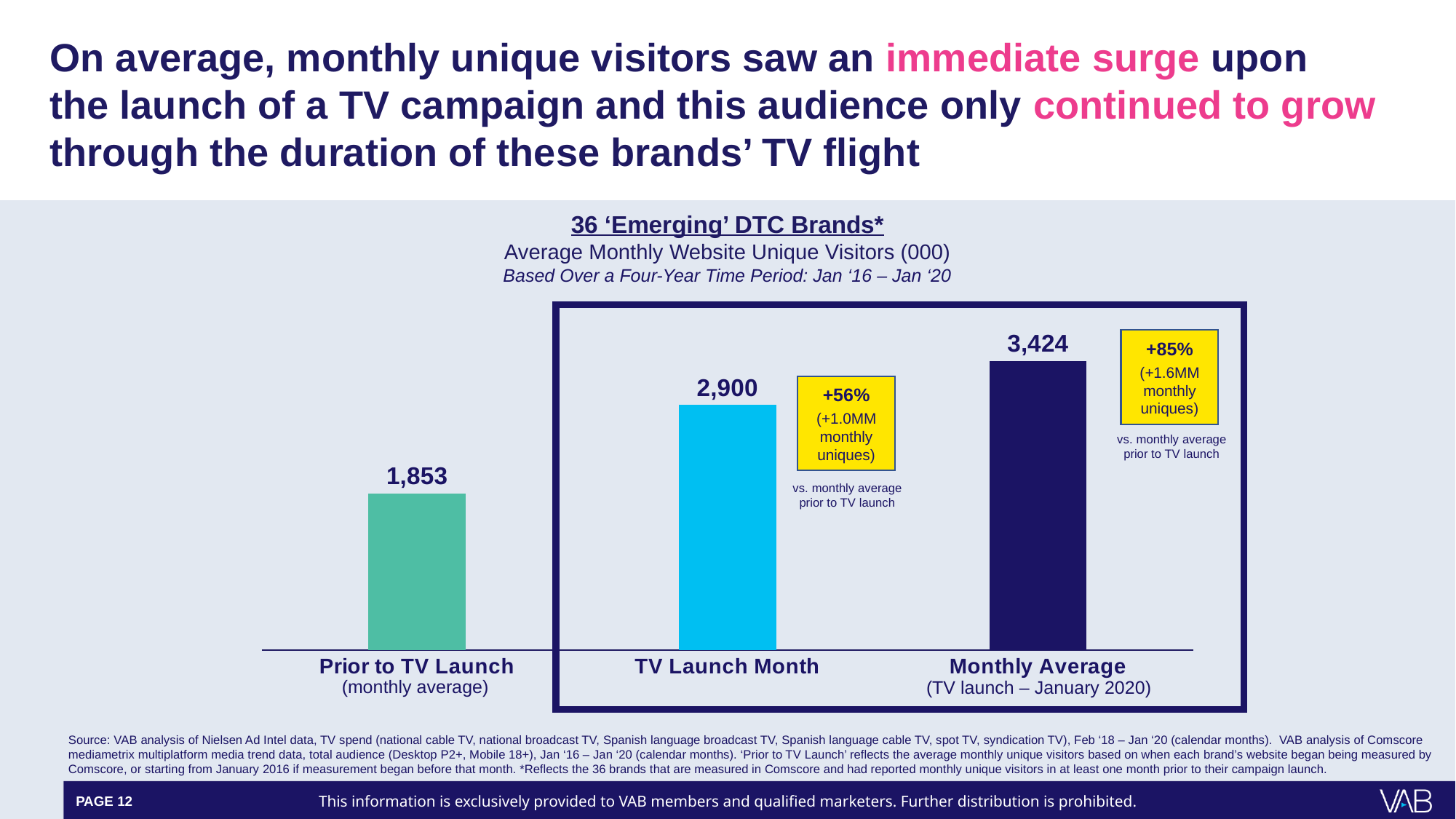
How many categories are shown in the chart? 3 Which category has the highest value? Monthly Average What is the difference between the Monthly Average and the Prior to TV Launch values? 1,571 What percentage increase is shown in the callout next to the Monthly Average bar? +85% What is the value for Prior to TV Launch? 1,853 What kind of chart is shown on the slide? Bar chart Do the values rise or fall from left to right across the categories? Rise Which category has the lowest value? Prior to TV Launch What is the value for Monthly Average (TV launch – January 2020)? 3,424 What is the value for TV Launch Month? 2,900 Which is larger, the value for TV Launch Month or the value for Prior to TV Launch? TV Launch Month What is the difference between the TV Launch Month and the Prior to TV Launch values? 1,047